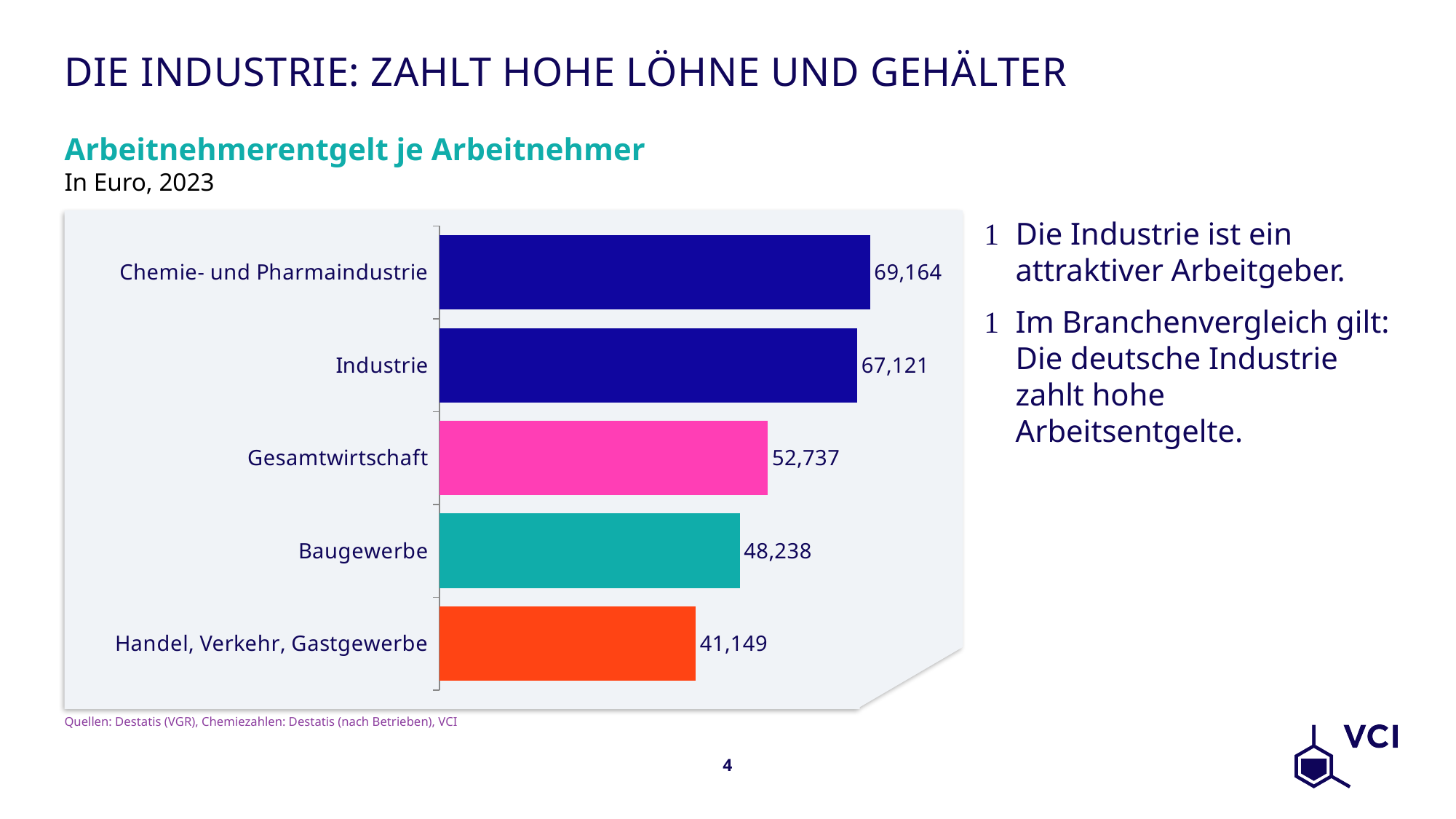
What is the difference between the values for Chemie- und Pharmaindustrie and Industrie? 2,043 Which category has the lowest value? Handel, Verkehr, Gastgewerbe What is the value for Handel, Verkehr, Gastgewerbe? 41,149 Which is larger, the value for Industrie or the value for Gesamtwirtschaft? Industrie What is the value for Baugewerbe? 48,238 What is the value for Gesamtwirtschaft? 52,737 Which category has the highest value? Chemie- und Pharmaindustrie What is the difference between the values for Gesamtwirtschaft and Baugewerbe? 4,499 What is the title of the chart? Arbeitnehmerentgelt je Arbeitnehmer What kind of chart is shown on the slide? Bar chart What is the value for Chemie- und Pharmaindustrie? 69,164 How many categories are shown in the chart? 5